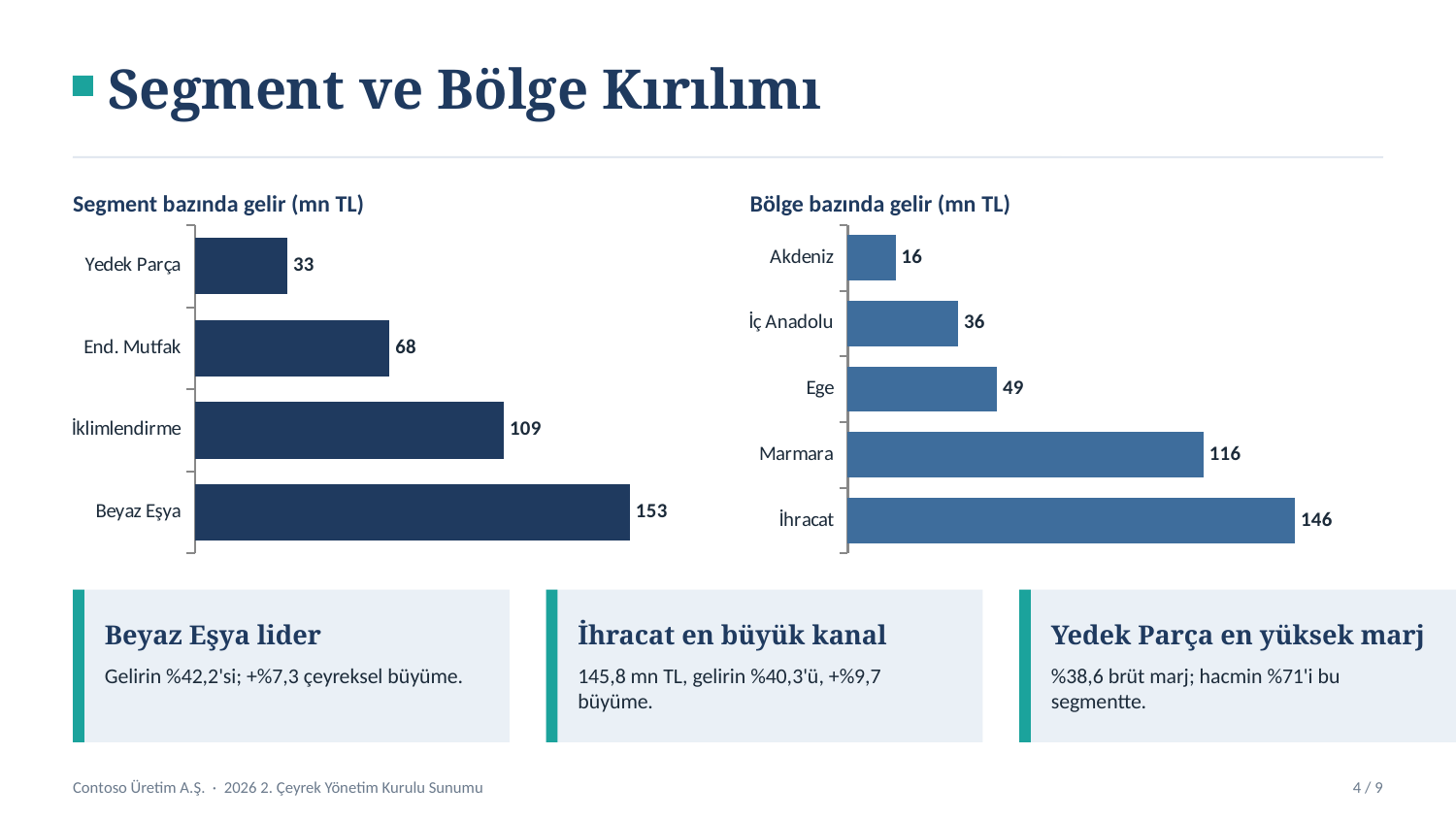
What kind of chart is the 'Bölge bazında gelir (mn TL)' chart? Bar chart In the 'Bölge bazında gelir (mn TL)' chart, what is the value for Ege? 49 In the 'Segment bazında gelir (mn TL)' chart, what is the difference between Beyaz Eşya and End. Mutfak? 85 In the 'Bölge bazında gelir (mn TL)' chart, which region has the lowest revenue? Akdeniz In the 'Segment bazında gelir (mn TL)' chart, which segment has the lowest revenue? Yedek Parça In the 'Bölge bazında gelir (mn TL)' chart, which is larger, Marmara or İhracat? İhracat What is the title of the chart on the left side of the slide? Segment bazında gelir (mn TL) In the 'Segment bazında gelir (mn TL)' chart, how many segments are shown? 4 In the 'Segment bazında gelir (mn TL)' chart, which segment has the highest revenue? Beyaz Eşya In the 'Bölge bazında gelir (mn TL)' chart, what is the difference between İhracat and Marmara? 30 In the 'Bölge bazında gelir (mn TL)' chart, how many regions are shown? 5 In the 'Segment bazında gelir (mn TL)' chart, what is the value for İklimlendirme? 109